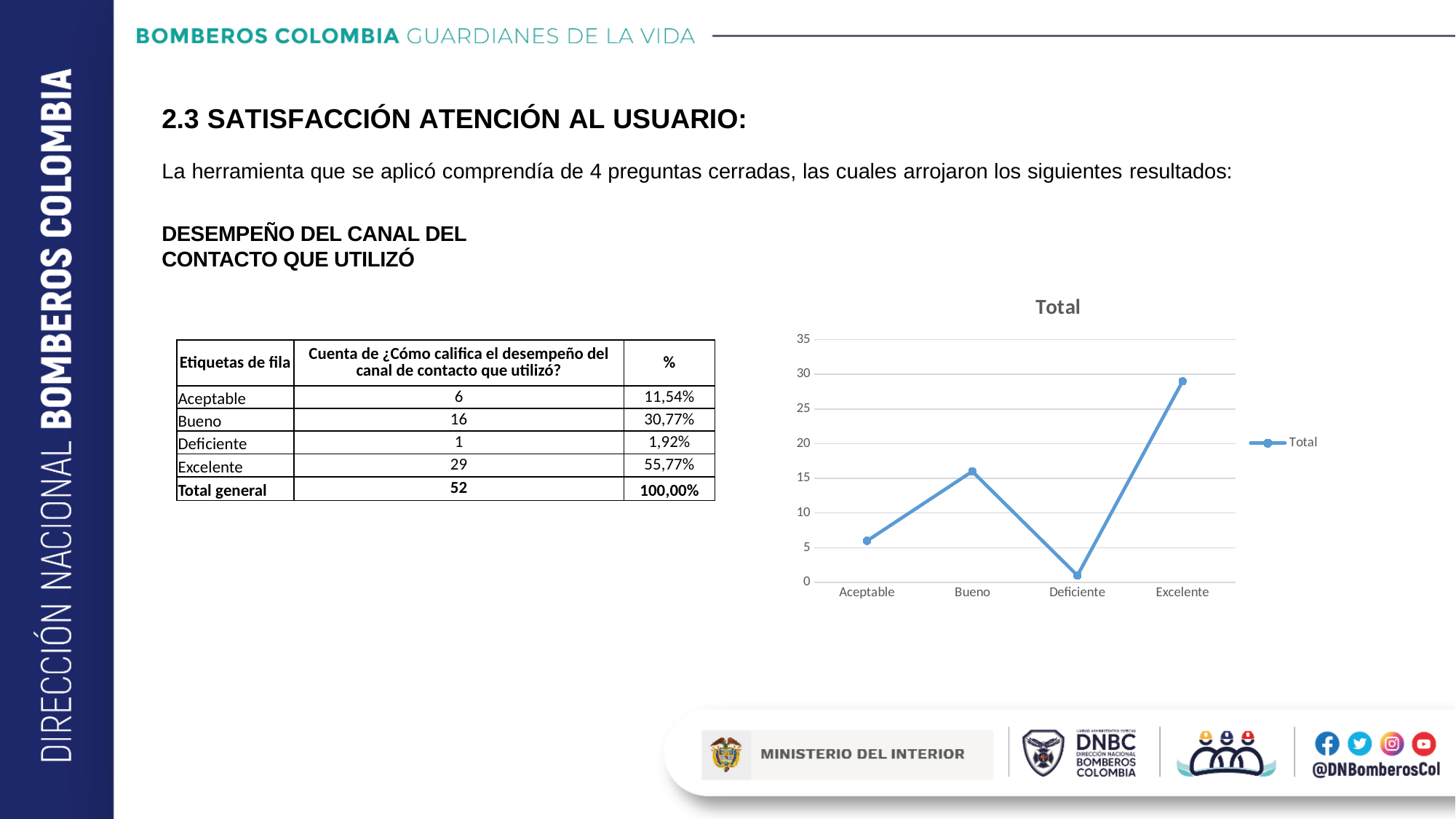
Is the value for Aceptable greater or less than 10? less What kind of chart is shown on the slide? line chart How many categories are plotted along the x axis of the chart? 4 Which is larger, the value for Bueno or the value for Aceptable? Bueno What is the title of the chart? Total How many series does the chart legend list? 1 Is the value for Bueno greater or less than 15? greater Which category has the lowest value in the chart? Deficiente Which category has the highest value in the chart? Excelente What is the value plotted for Excelente, as given in the table on the slide? 29 What is the difference between the values for Excelente and Bueno, using the figures in the table? 13 Is the value for Excelente greater or less than 25? greater